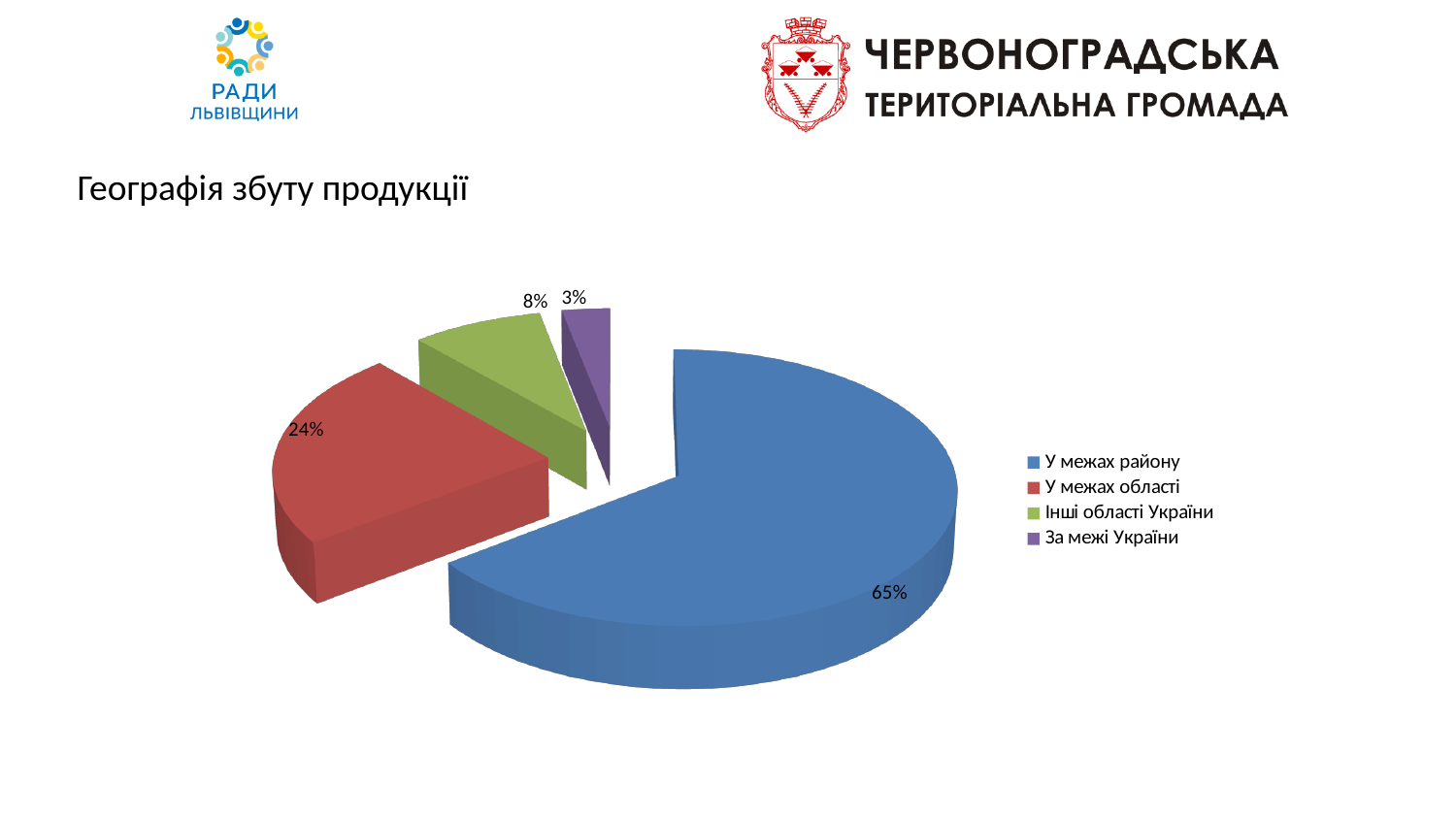
What is the difference between the shares of 'У межах району' and 'У межах області'? 41% What is the value shown for 'За межі України'? 3% What kind of chart is shown on the slide? Pie chart Which is larger: the share for 'Інші області України' or for 'За межі України'? Інші області України What share of the pie does 'У межах району' represent? 65% What is the title of the chart? Географія збуту продукції Which category has the largest share of the pie? У межах району What colour is the slice for 'У межах області'? Red Which category has the smallest share of the pie? За межі України How many categories does the pie chart show? 4 What is the value shown for 'У межах області'? 24% What is the value shown for 'Інші області України'? 8%